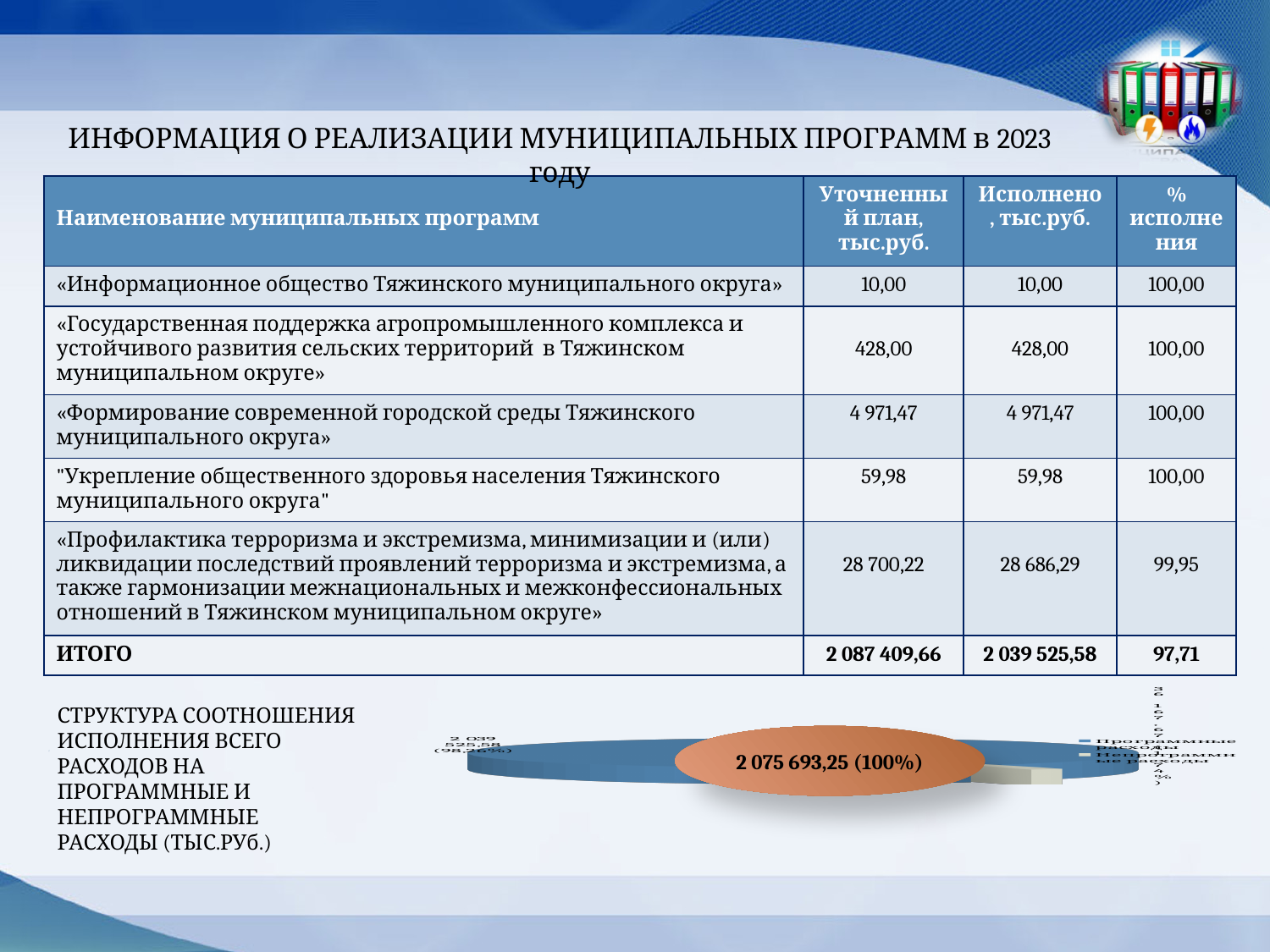
What are the two legend entries of the pie chart? Программные расходы and Непрограммные расходы How many entries does the legend of the pie chart list? 2 In the pie chart, which is larger: Программные расходы or Непрограммные расходы? Программные расходы What value is printed on the pie chart for Программные расходы? 2 039 525,58 Which slice of the pie chart is the largest? Программные расходы What kind of chart is shown at the bottom of the slide? pie chart What total value is printed in the centre of the pie chart? 2 075 693,25 (100%) Is the share of Программные расходы in the pie chart greater or less than 50%? greater How many slices does the pie chart have? 2 Which slice of the pie chart is the smallest? Непрограммные расходы What share of the pie chart do Программные расходы make up? 98,26%